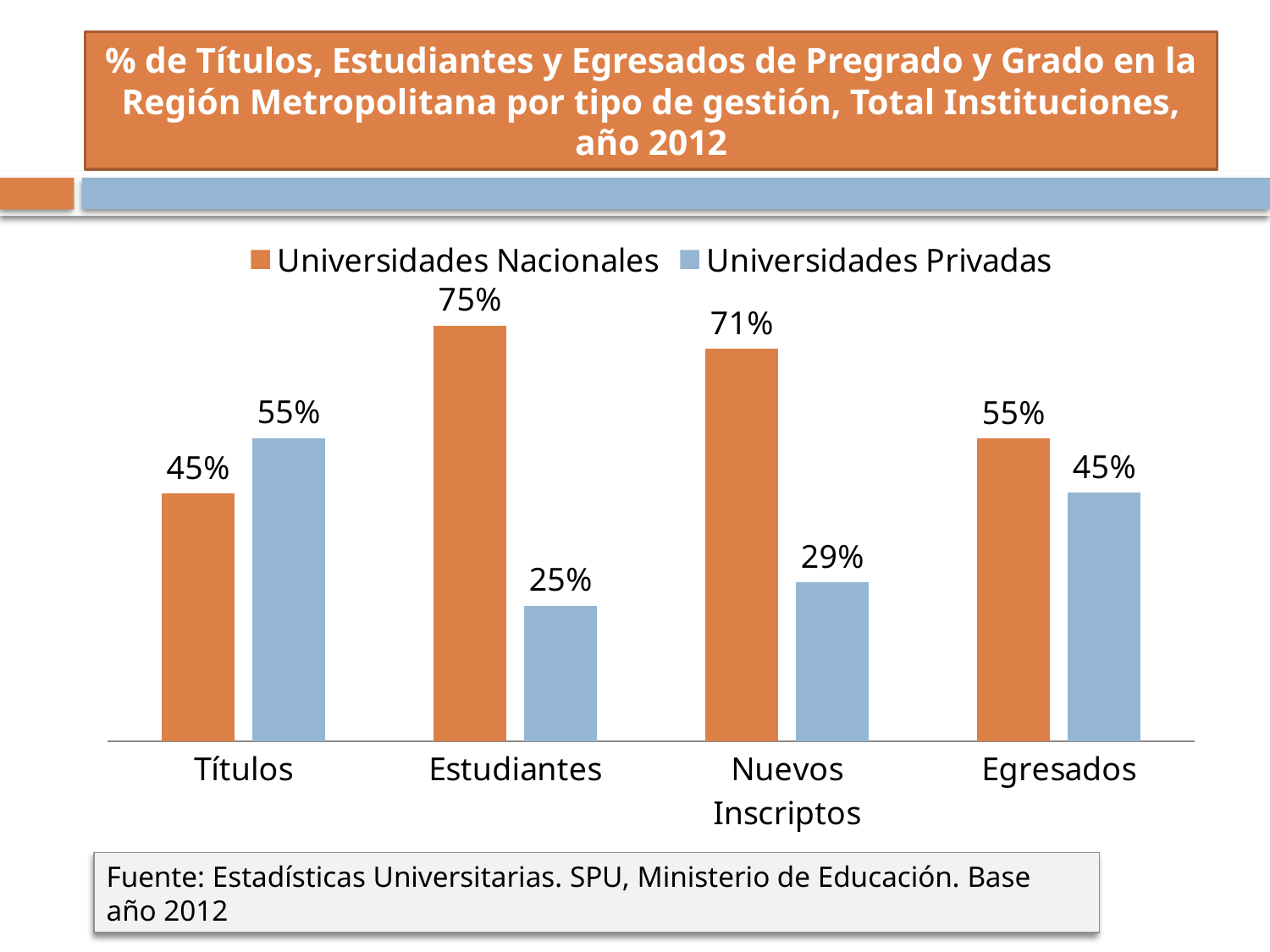
In which category is the Universidades Privadas value lowest? Estudiantes How many categories are shown on the x axis? 4 Which colour represents Universidades Privadas in the chart? Blue What is the value for Universidades Nacionales in the Estudiantes category? 75% In which category is the Universidades Nacionales value highest? Estudiantes What is the value for Universidades Nacionales in the Egresados category? 55% How many series does the legend list? 2 What is the value for Universidades Privadas in the Títulos category? 55% What kind of chart is shown on the slide? Bar chart What is the difference between Universidades Nacionales and Universidades Privadas in the Nuevos Inscriptos category? 42% Which is larger in the Títulos category, Universidades Nacionales or Universidades Privadas? Universidades Privadas What is the value for Universidades Privadas in the Nuevos Inscriptos category? 29%